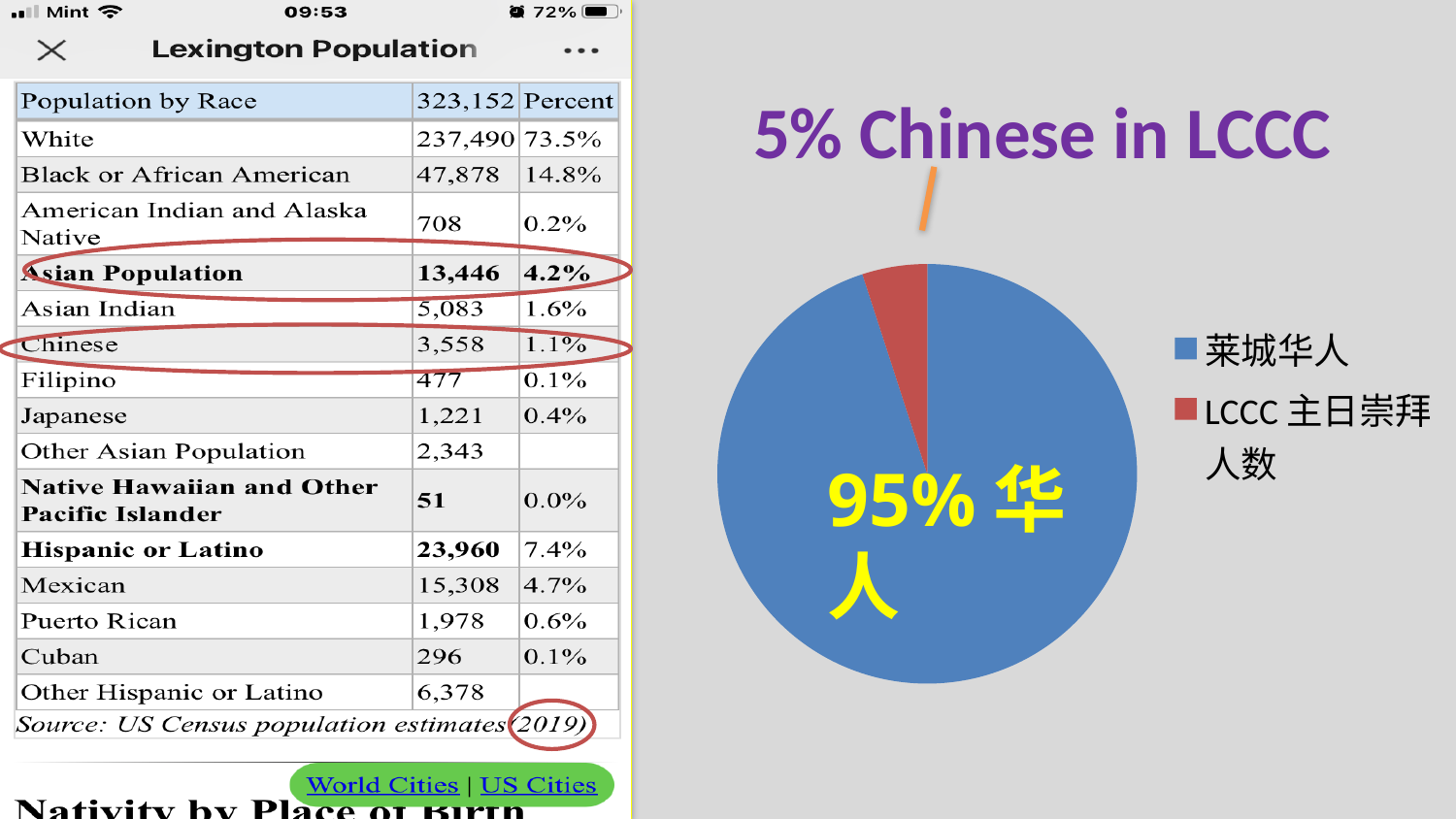
What kind of chart is shown on the right side of the slide? pie chart What percentage is labelled on the large blue slice of the pie chart? 95% How many entries does the pie chart's legend list? 2 Which legend entry corresponds to the smaller slice of the pie chart? LCCC 主日崇拜人数 What colour is the slice representing 莱城华人 in the pie chart? blue What percentage of the pie chart is labelled as Chinese in LCCC? 5% Is the share of the pie chart for LCCC 主日崇拜人数 greater or less than 50%? less How many slices does the pie chart have? 2 Which slice is larger in the pie chart, 莱城华人 or LCCC 主日崇拜人数? 莱城华人 What is the difference in percentage points between the 95% slice and the 5% slice of the pie chart? 90 Which legend entry corresponds to the larger slice of the pie chart? 莱城华人 What colour is the slice representing LCCC 主日崇拜人数 in the pie chart? red